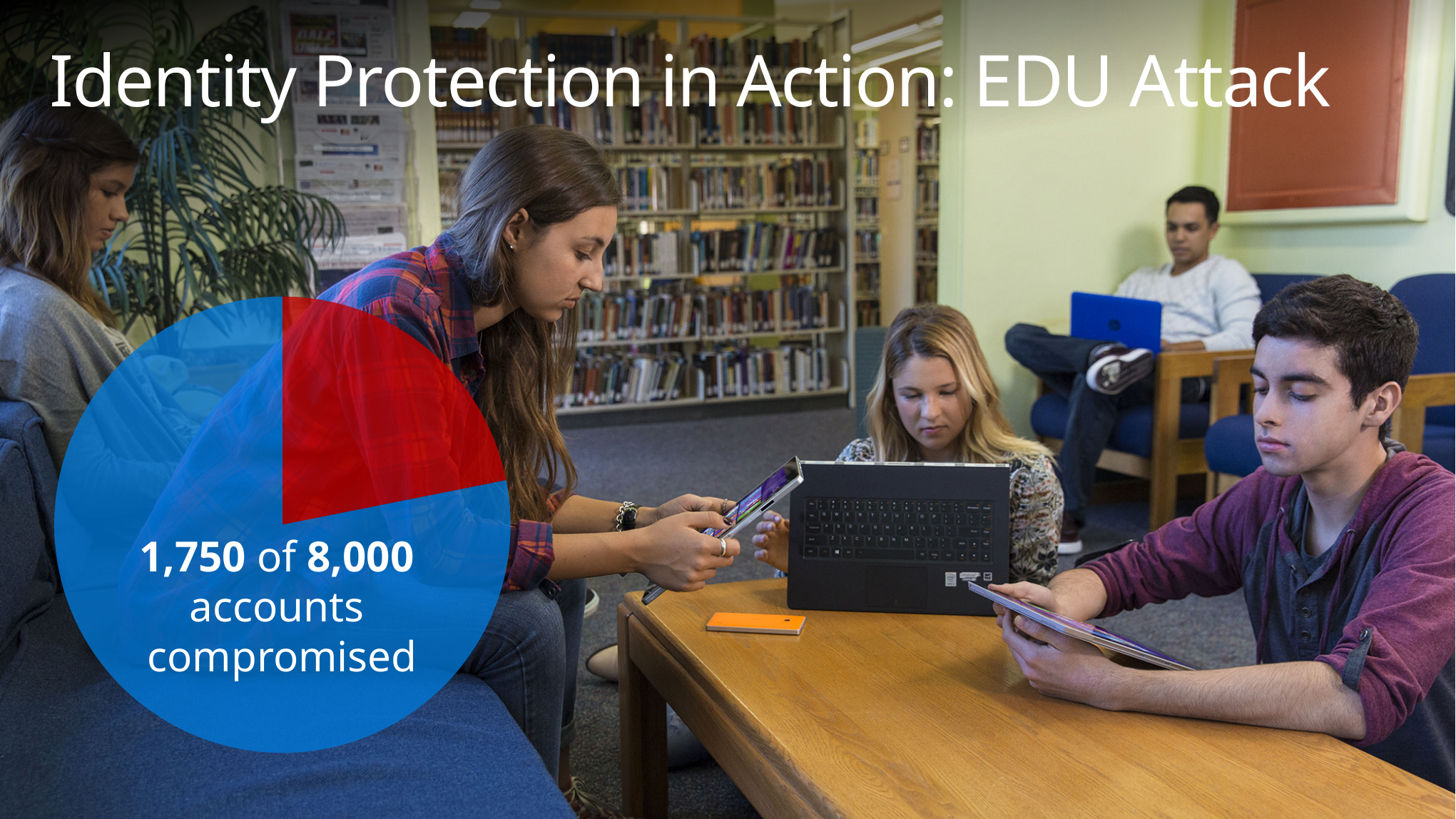
How many accounts were compromised according to the pie chart? 1,750 What is the title of the slide containing the pie chart? Identity Protection in Action: EDU Attack Is the number of compromised accounts greater or less than half of the 8,000 total? less What kind of chart is shown on the slide? pie chart What is the total number of accounts represented by the pie chart? 8,000 How many accounts were not compromised, based on the figures printed on the pie chart? 6,250 Which slice of the pie chart is larger, the red slice or the blue slice? the blue slice How many slices does the pie chart have? 2 What colour is the slice representing the compromised accounts in the pie chart? red Is the number of compromised accounts greater or less than 2,000? less